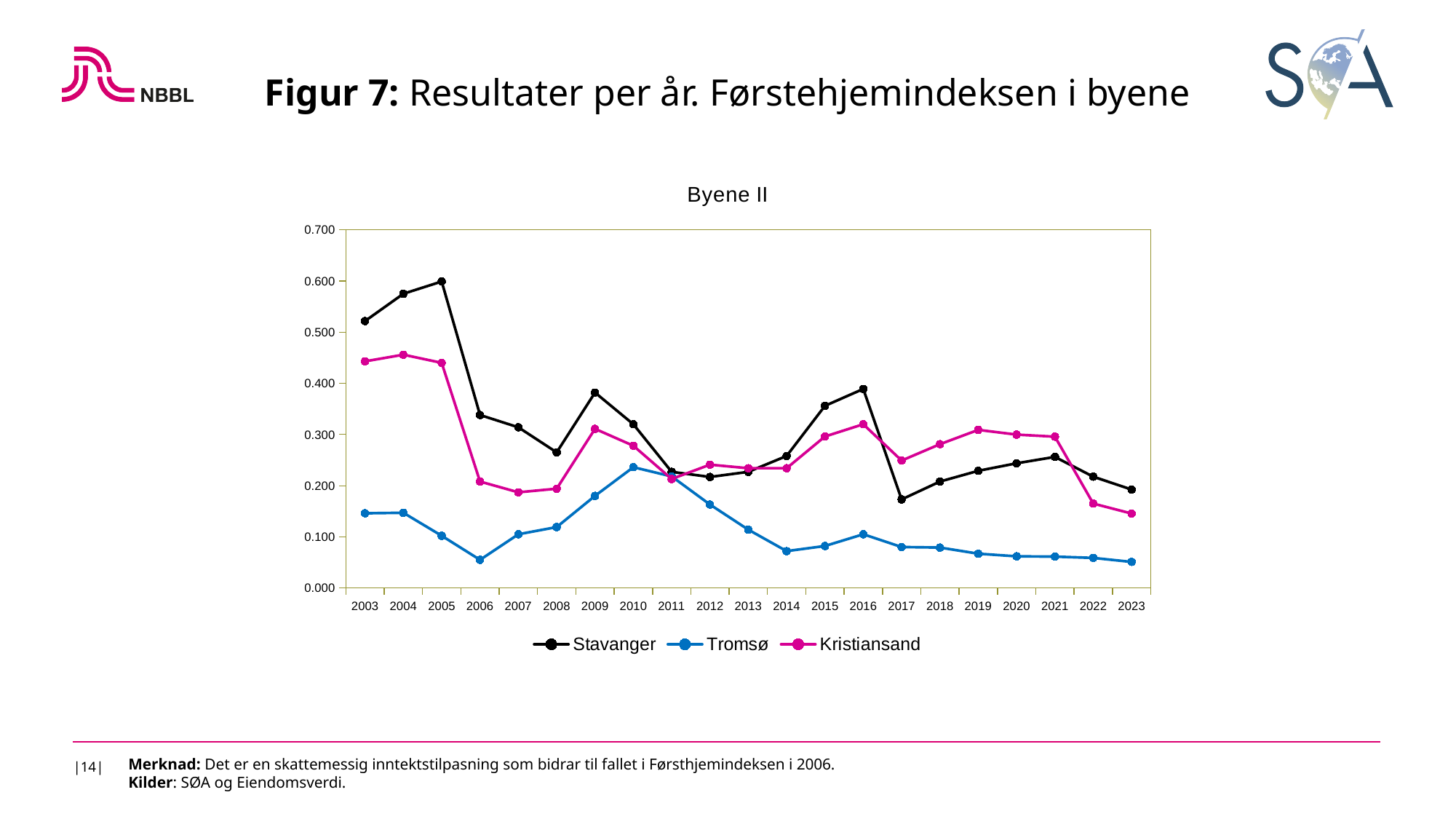
What is the title shown above the chart? Byene II Is the value for Stavanger in 2005 greater or less than 0.500? greater In which year does Stavanger reach its highest value? 2005 How many years are plotted along the x axis? 21 In which year does Stavanger reach its lowest value? 2017 What kind of chart is shown on the slide? line chart In which year does Kristiansand reach its lowest value? 2023 Is the value for Tromsø in 2010 greater or less than 0.200? greater How many series does the legend list? 3 Does the Tromsø line rise or fall from 2010 to 2014? fall In 2019, which is larger: Kristiansand or Stavanger? Kristiansand Is the value for Kristiansand in 2006 greater or less than 0.300? less